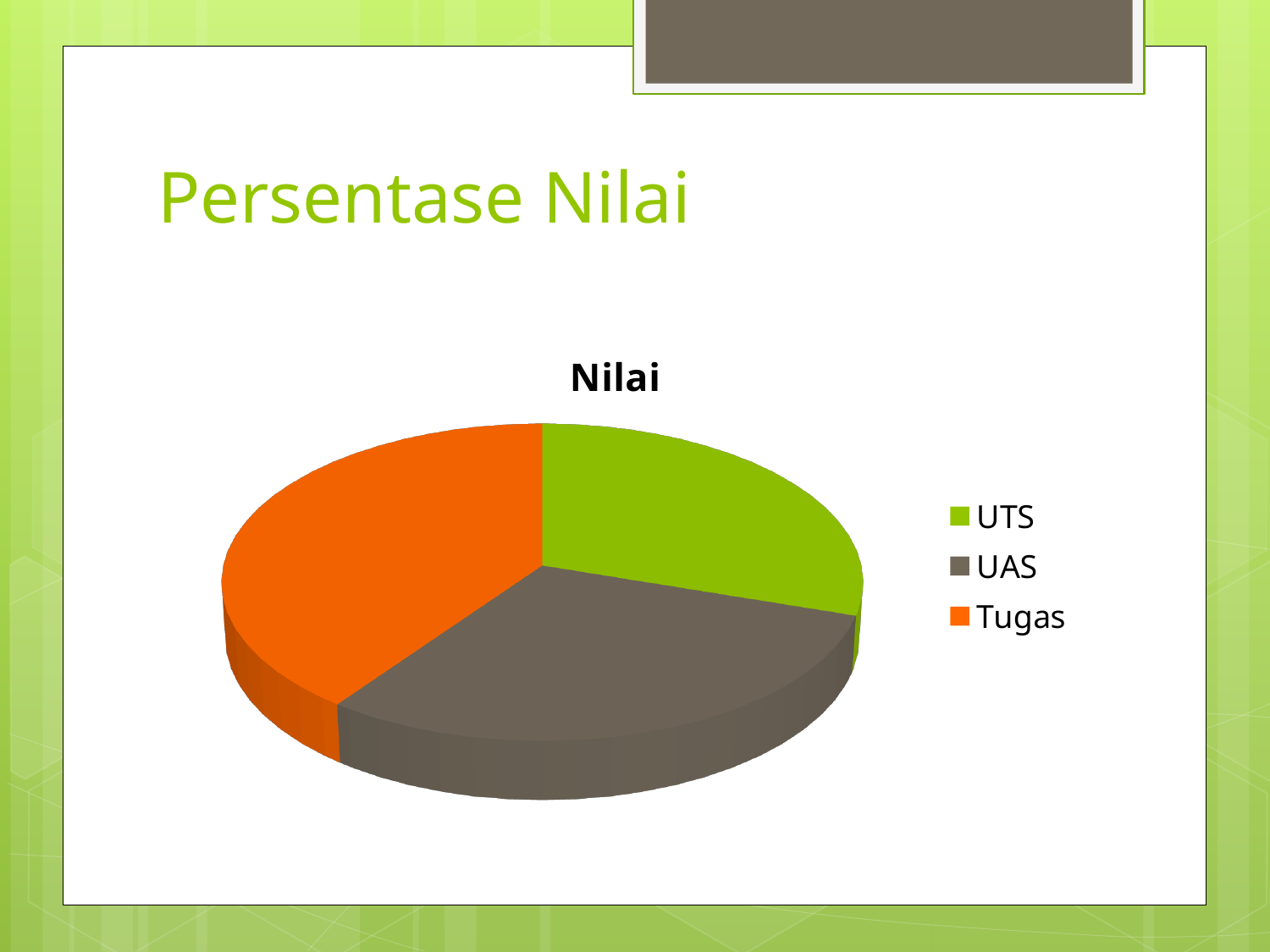
Which slice is larger, UTS or Tugas? Tugas How many slices does the pie chart have? 3 Which colour represents Tugas in the pie chart? orange What is the title of the chart? Nilai What kind of chart is shown on the slide? pie chart How many entries does the legend list? 3 Which category is shown in green? UTS